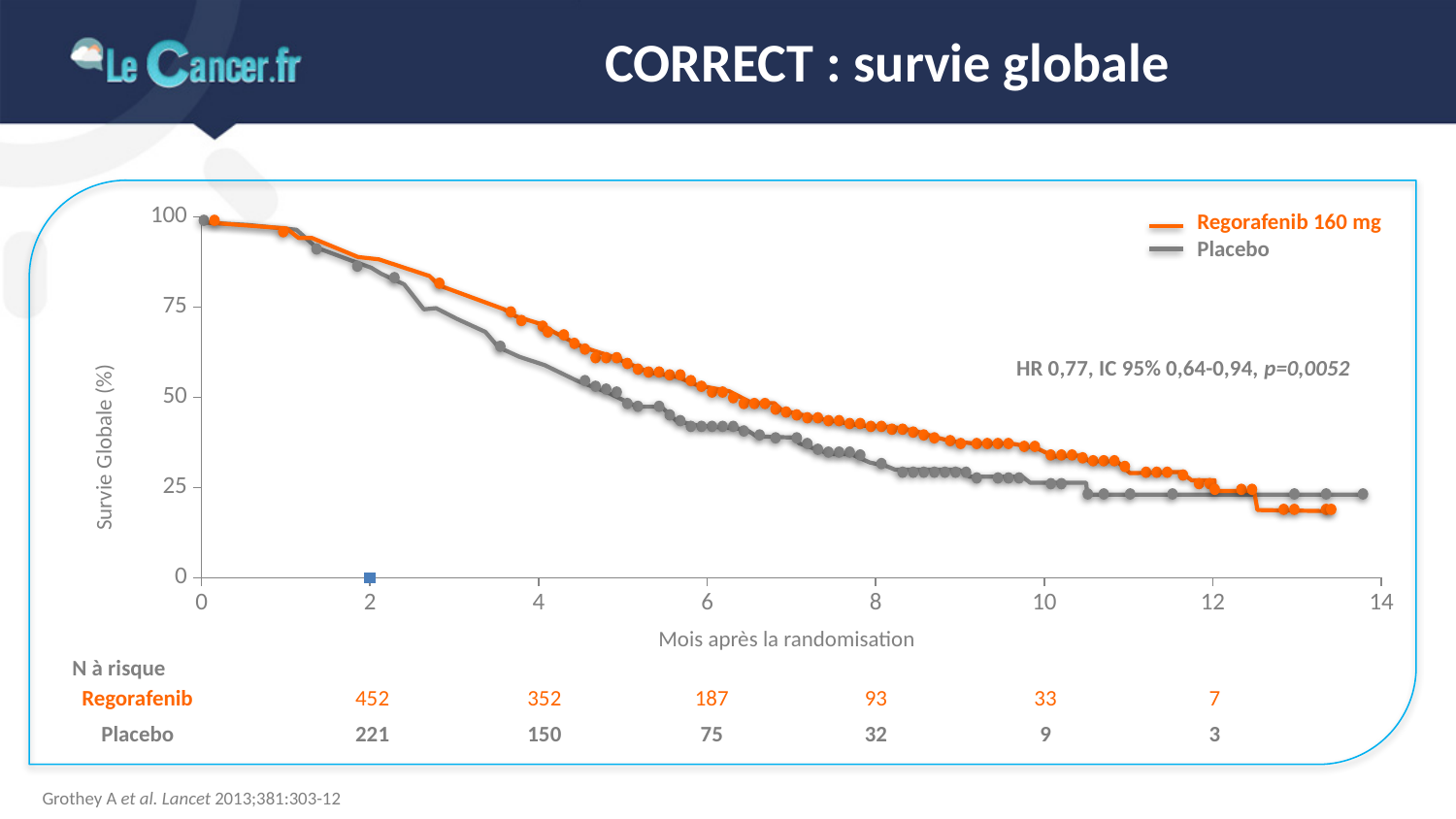
In the 'N à risque' table, what is the difference between the Regorafenib and Placebo numbers at risk at 4 months? 202 Do the survival curves rise or fall as months after randomisation increase? fall At 8 months, which series has the higher survival value, Regorafenib 160 mg or Placebo? Regorafenib 160 mg At 6 months, is the Placebo survival value greater or less than 50? less What kind of chart is shown on the slide? line chart At 10 months, is the Regorafenib 160 mg survival value greater or less than 25? greater In the 'N à risque' table, how many Regorafenib patients are at risk at 2 months? 452 What is the label of the x axis? Mois après la randomisation What are the two series named in the legend? Regorafenib 160 mg and Placebo How many series does the legend list? 2 At 2 months, is the Regorafenib 160 mg survival value greater or less than 75? greater